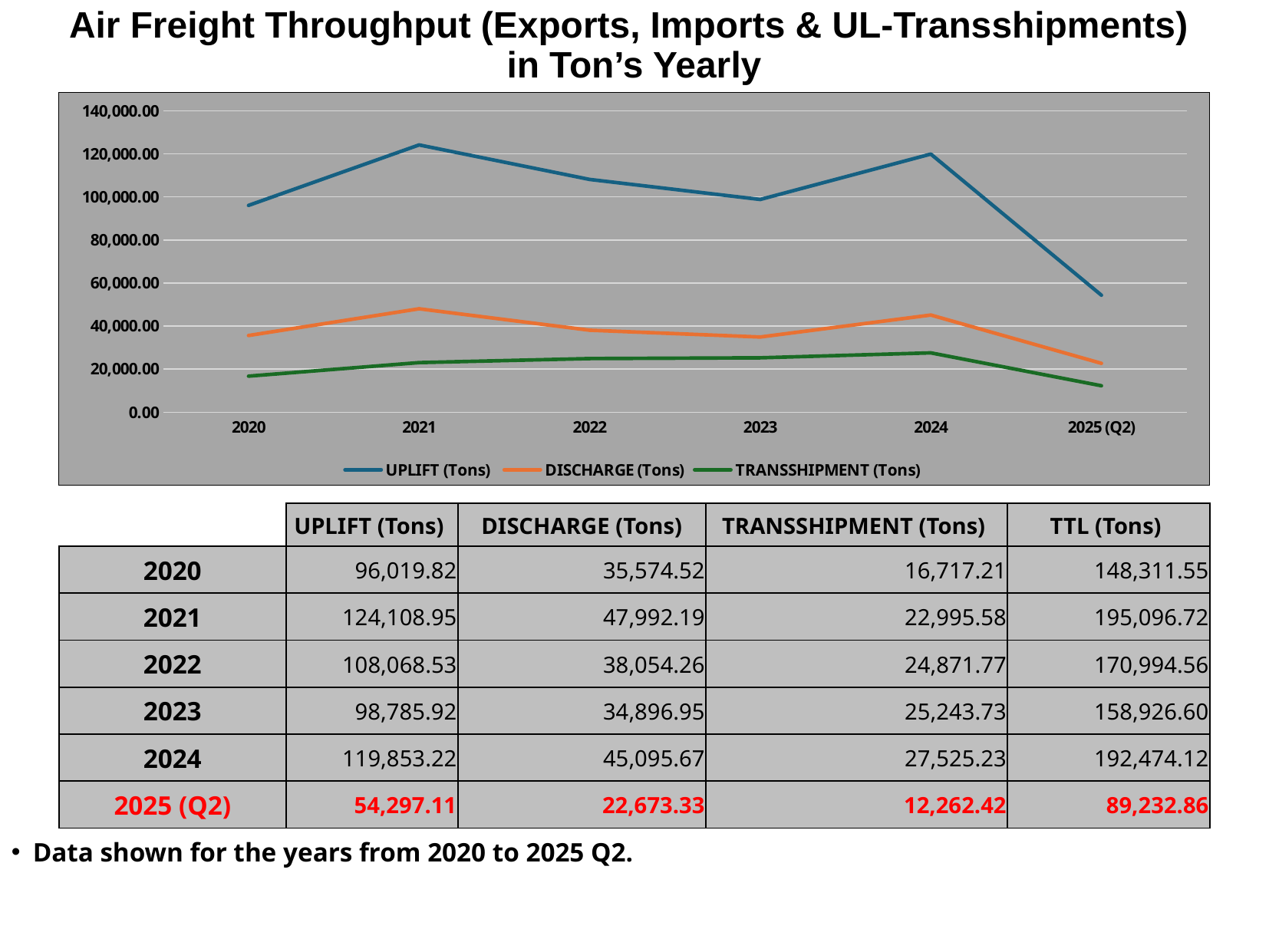
Is the UPLIFT (Tons) value for 2025 (Q2) greater or less than 60,000.00? less What is the UPLIFT (Tons) value for 2021? 124,108.95 How many points along the x axis does the chart show? 6 In which period is TRANSSHIPMENT (Tons) lowest? 2025 (Q2) How many series does the chart legend list? 3 What kind of chart is shown on the slide? line chart What is the difference between UPLIFT (Tons) in 2024 and in 2023? 21,067.30 Which is larger, DISCHARGE (Tons) in 2021 or DISCHARGE (Tons) in 2022? 2021 What is the TRANSSHIPMENT (Tons) value for 2023? 25,243.73 Does UPLIFT (Tons) rise or fall from 2024 to 2025 (Q2)? fall What is the DISCHARGE (Tons) value for 2024? 45,095.67 In which year is UPLIFT (Tons) highest? 2021